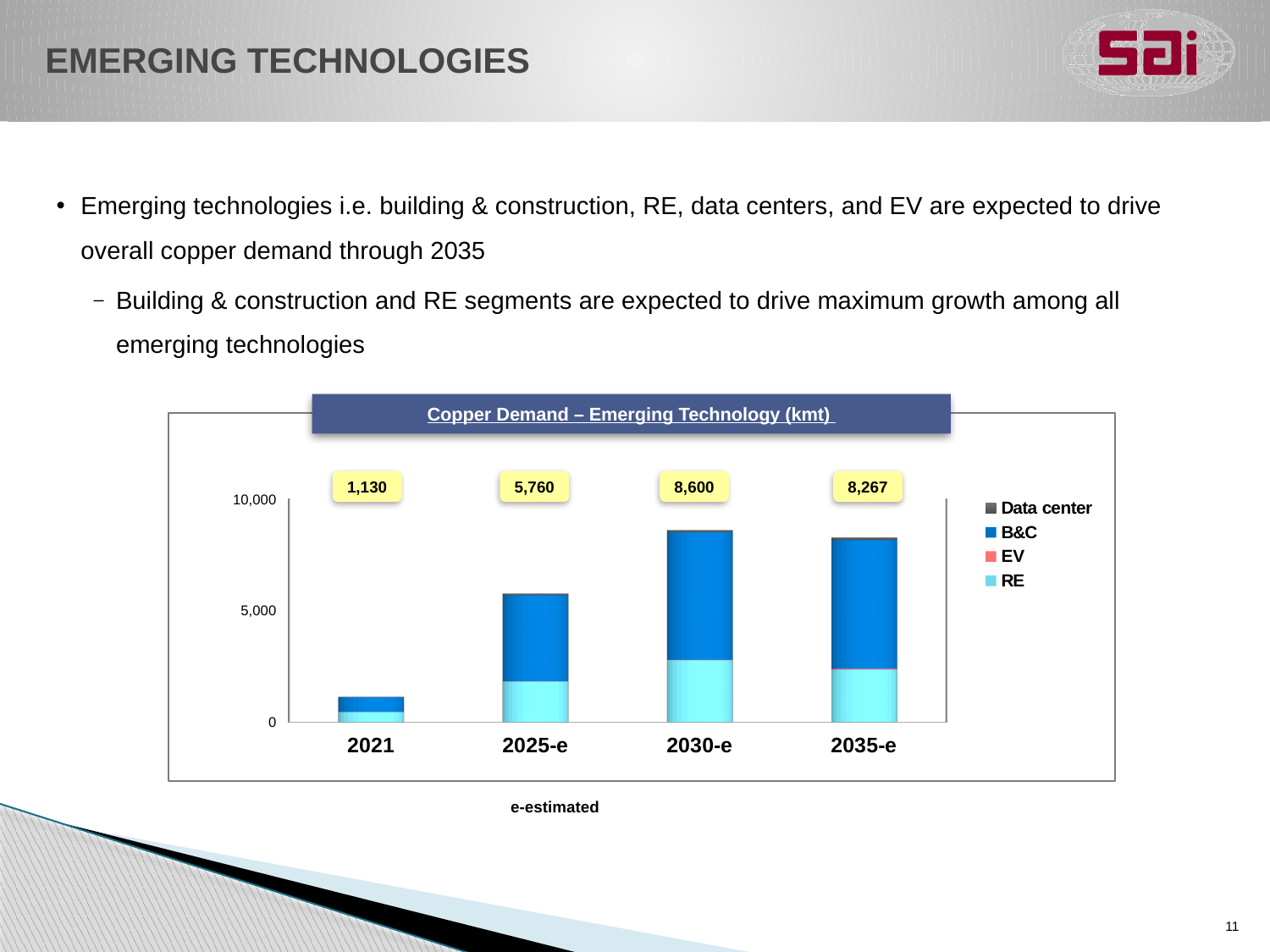
What is the total copper demand shown for 2025-e? 5,760 Which is larger, the total copper demand for 2025-e or for 2035-e? 2035-e How many series does the chart's legend list? 4 What is the total copper demand shown for 2035-e? 8,267 What kind of chart is used to show copper demand from emerging technology? Stacked bar chart How many years (categories) are shown on the x axis of the chart? 4 Which year has the lowest total copper demand in the chart? 2021 Which year has the highest total copper demand in the chart? 2030-e What is the total copper demand shown for 2030-e? 8,600 What is the difference between the total copper demand for 2030-e and 2035-e? 333 Is the RE segment for 2030-e greater or less than 5,000? less What is the total copper demand shown for 2021 in the Copper Demand – Emerging Technology chart? 1,130